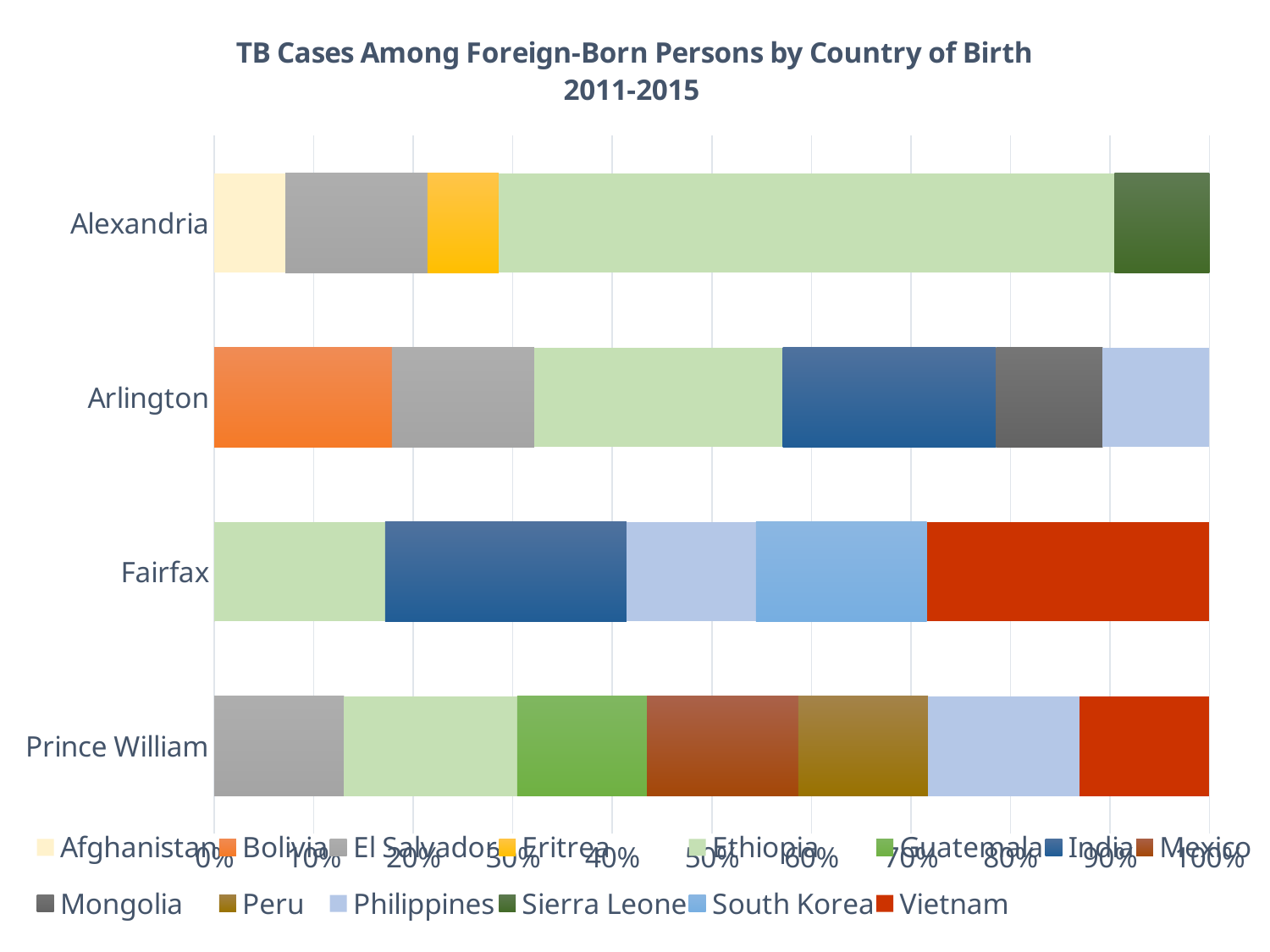
How many jurisdictions (bars) are shown in the chart? 4 How many countries of birth does the legend list? 14 In the Alexandria bar, which is larger: the share for Ethiopia or the share for El Salvador? Ethiopia Is the share for Vietnam in the Fairfax bar greater or less than 20%? greater Is the share for Afghanistan in the Alexandria bar greater or less than 10%? less Is the share for Ethiopia in the Alexandria bar greater or less than 50%? greater In the Fairfax bar, which is larger: the share for Vietnam or the share for Philippines? Vietnam Which country of birth accounts for the largest share of the Alexandria bar? Ethiopia Which jurisdiction's bar includes a segment for Sierra Leone? Alexandria What type of chart is shown on the slide? Bar chart What is the title of the chart? TB Cases Among Foreign-Born Persons by Country of Birth 2011-2015